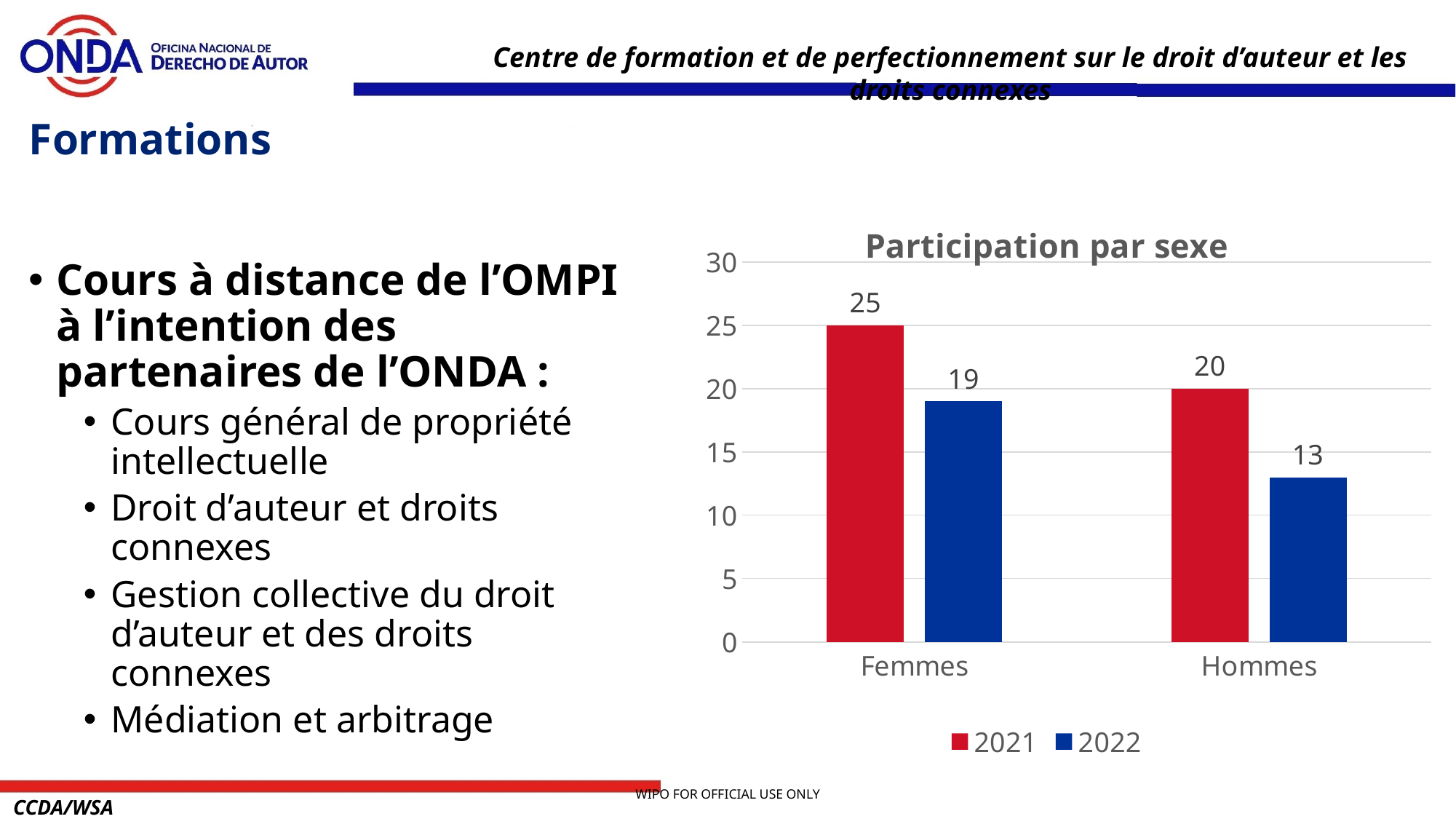
What is the title of the chart? Participation par sexe How many series does the legend list? 2 What is the value for Femmes in 2022? 19 What is the difference between the 2021 and 2022 values for Hommes? 7 Which is larger: the 2022 value for Femmes or the 2021 value for Hommes? 2021 value for Hommes What is the difference between the 2021 and 2022 values for Femmes? 6 What is the value for Hommes in 2022? 13 What is the value for Hommes in 2021? 20 How many categories are shown on the x axis? 2 What is the value for Femmes in 2021? 25 Which category has the lowest value in the 2022 series? Hommes Which category has the highest value in the 2021 series? Femmes